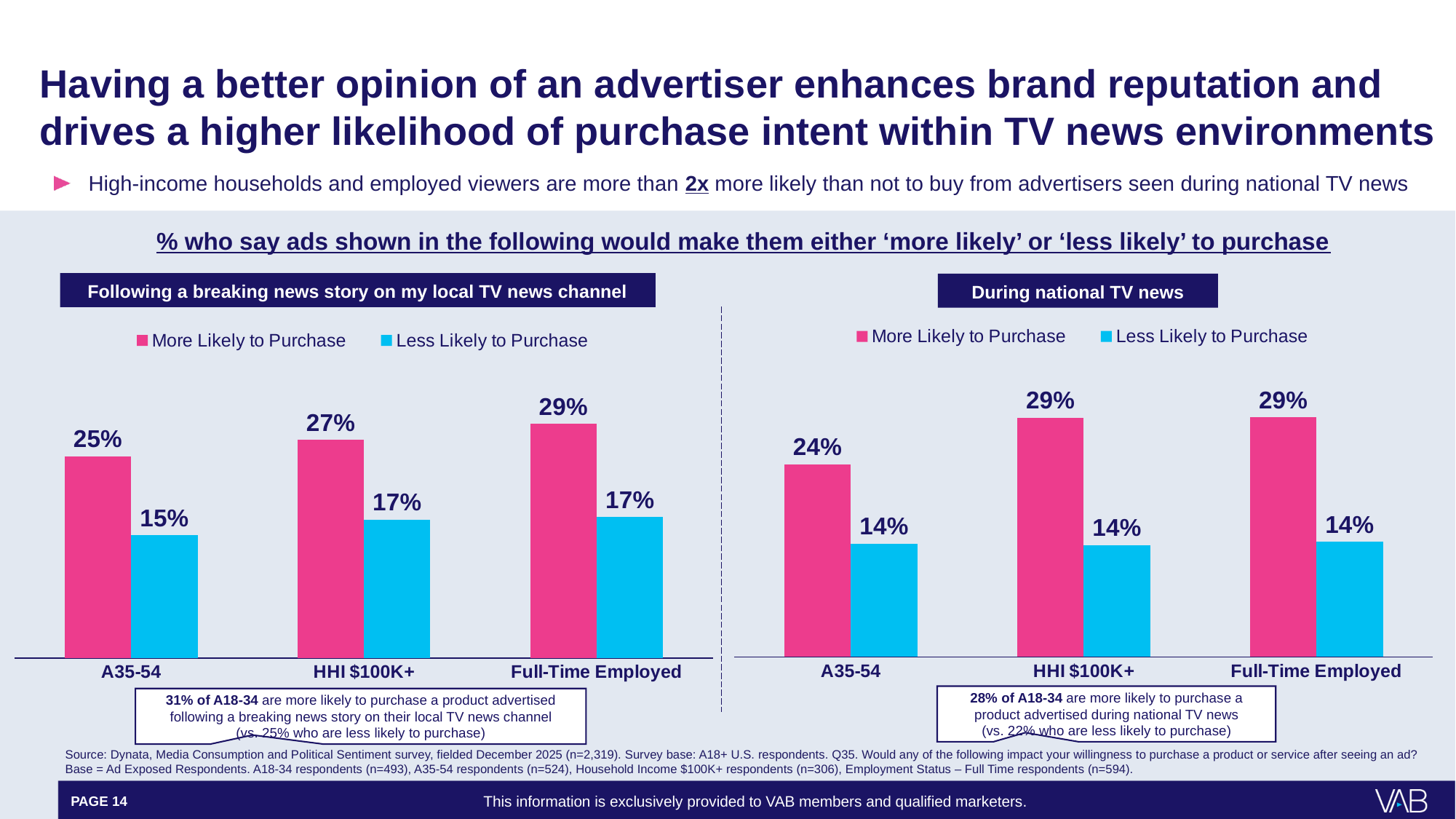
What kind of chart is the 'During national TV news' chart? Bar chart In the 'During national TV news' chart, which category has the lowest 'More Likely to Purchase' value? A35-54 In the 'During national TV news' chart, which is larger for A35-54: 'More Likely to Purchase' or 'Less Likely to Purchase'? More Likely to Purchase In the 'During national TV news' chart, what is the 'Less Likely to Purchase' value for HHI $100K+? 14% In the 'Following a breaking news story on my local TV news channel' chart, what is the 'More Likely to Purchase' value for A35-54? 25% In the 'During national TV news' chart, what is the difference between 'More Likely to Purchase' and 'Less Likely to Purchase' for Full-Time Employed? 15% How many categories are shown on the x axis of the 'Following a breaking news story on my local TV news channel' chart? 3 In the 'Following a breaking news story on my local TV news channel' chart, which category has the highest 'More Likely to Purchase' value? Full-Time Employed In the 'Following a breaking news story on my local TV news channel' chart, do the 'More Likely to Purchase' values rise or fall from A35-54 to Full-Time Employed? Rise In the 'Following a breaking news story on my local TV news channel' chart, what is the difference between 'More Likely to Purchase' and 'Less Likely to Purchase' for HHI $100K+? 10% How many series does the legend of the 'During national TV news' chart list? 2 In the 'Following a breaking news story on my local TV news channel' chart, what colour are the 'Less Likely to Purchase' bars? Blue